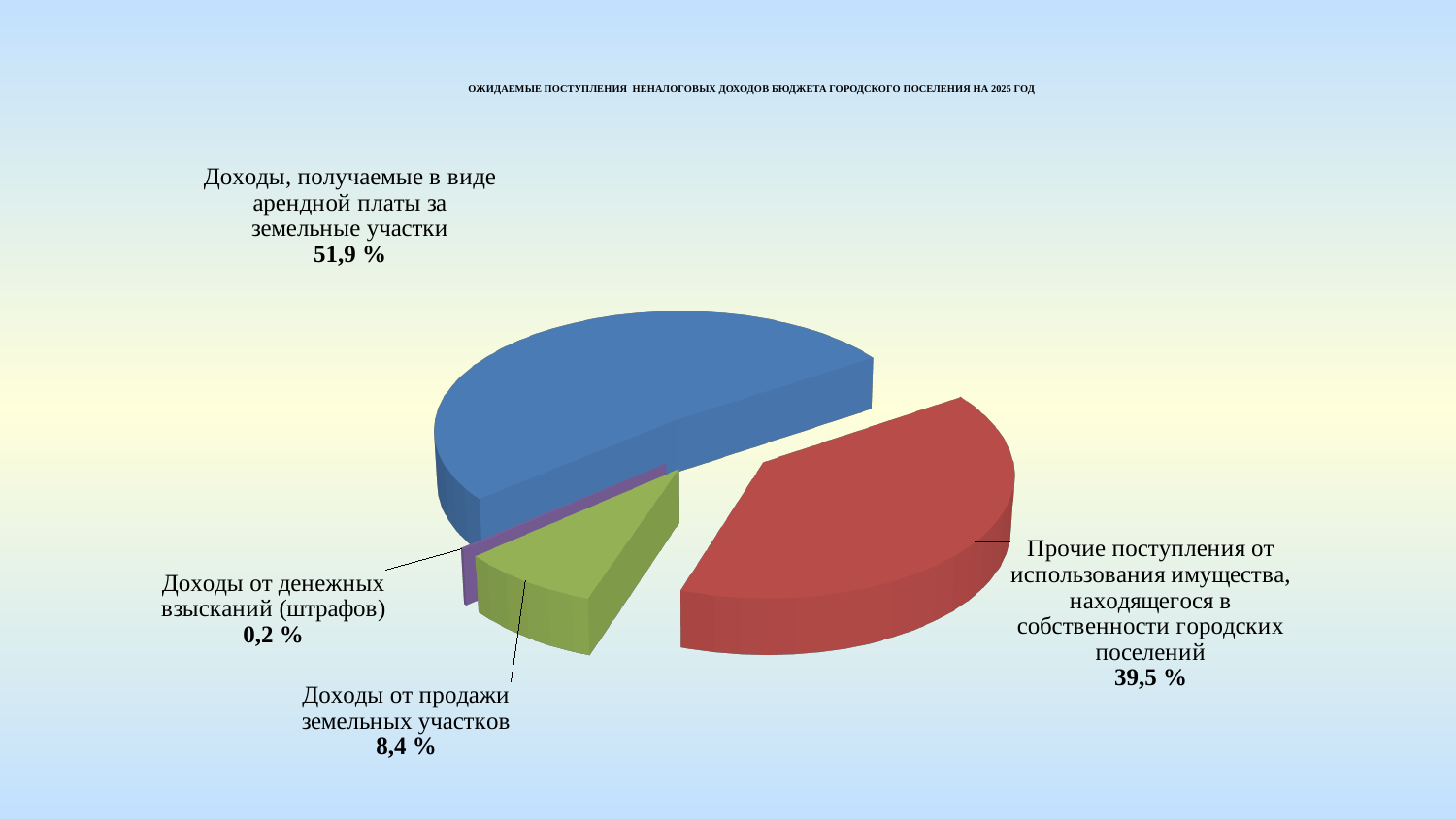
What type of chart is shown on the slide? Pie chart What is the difference in percentage points between the share for rental income from land plots (51,9 %) and other income from use of property (39,5 %)? 12,4 What colour is the slice for "Прочие поступления от использования имущества, находящегося в собственности городских поселений"? Red Which category has the largest share of the pie? Доходы, получаемые в виде арендной платы за земельные участки What share is shown for "Доходы от продажи земельных участков"? 8,4 % What share of the pie is labelled for "Доходы, получаемые в виде арендной платы за земельные участки"? 51,9 % What year does the chart title refer to? 2025 Which category has the smallest share of the pie? Доходы от денежных взысканий (штрафов) What share is shown for "Прочие поступления от использования имущества, находящегося в собственности городских поселений"? 39,5 % How many slices does the pie chart have? 4 What share is shown for "Доходы от денежных взысканий (штрафов)"? 0,2 % Which is larger: the share for "Доходы от продажи земельных участков" or the share for "Доходы от денежных взысканий (штрафов)"? Доходы от продажи земельных участков